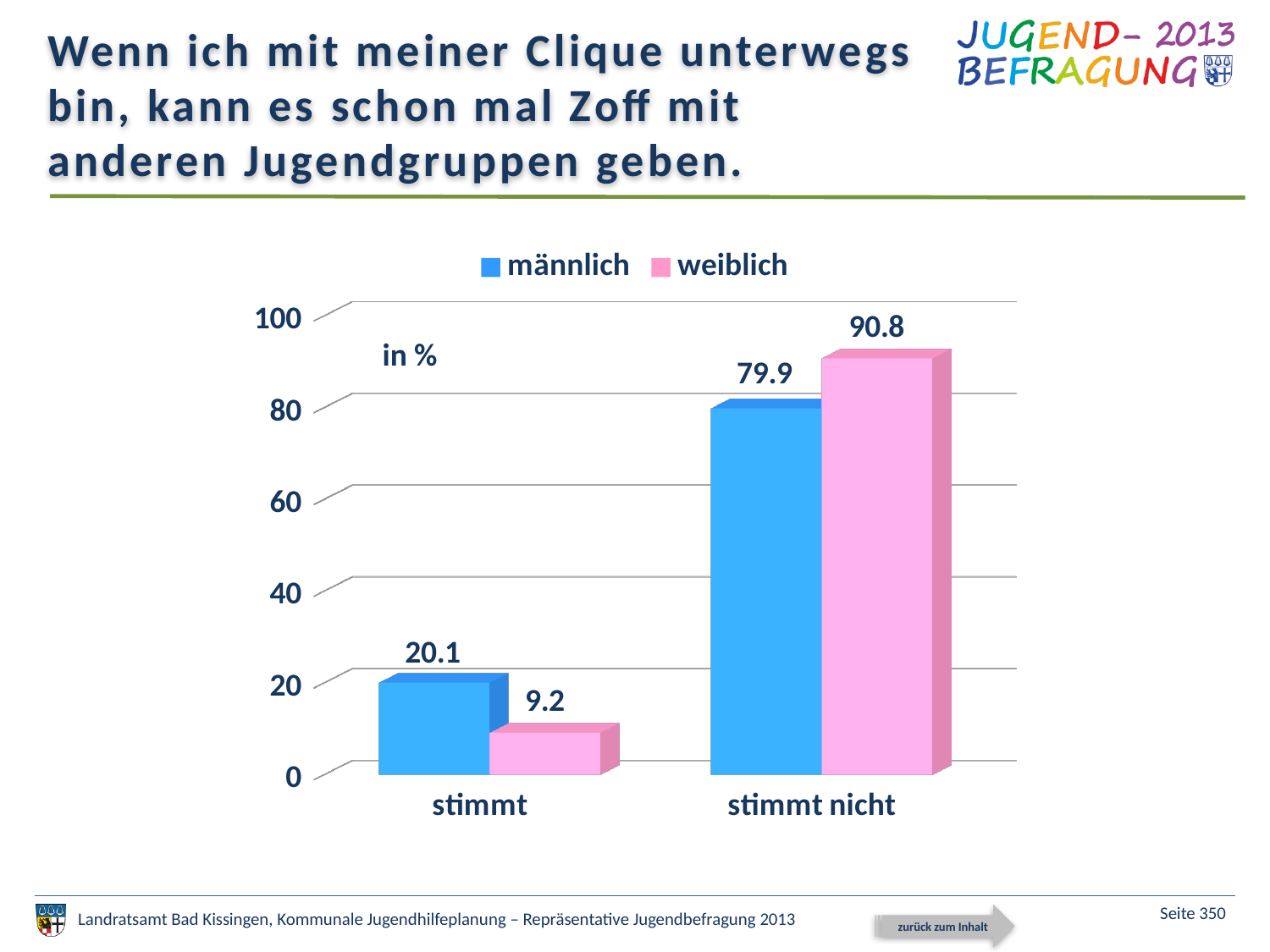
What is the value for männlich in the stimmt nicht category? 79.9 In the stimmt category, which series has the larger value, männlich or weiblich? männlich What is the value for weiblich in the stimmt category? 9.2 What is the value for männlich in the stimmt category? 20.1 What kind of chart is shown on the slide? bar chart What is the difference between the männlich and weiblich values in the stimmt category? 10.9 How many categories are shown on the x axis? 2 What is the value for weiblich in the stimmt nicht category? 90.8 Which bar has the highest value on the chart? weiblich, stimmt nicht Which bar has the lowest value on the chart? weiblich, stimmt What is the difference between the weiblich and männlich values in the stimmt nicht category? 10.9 How many series does the legend list? 2